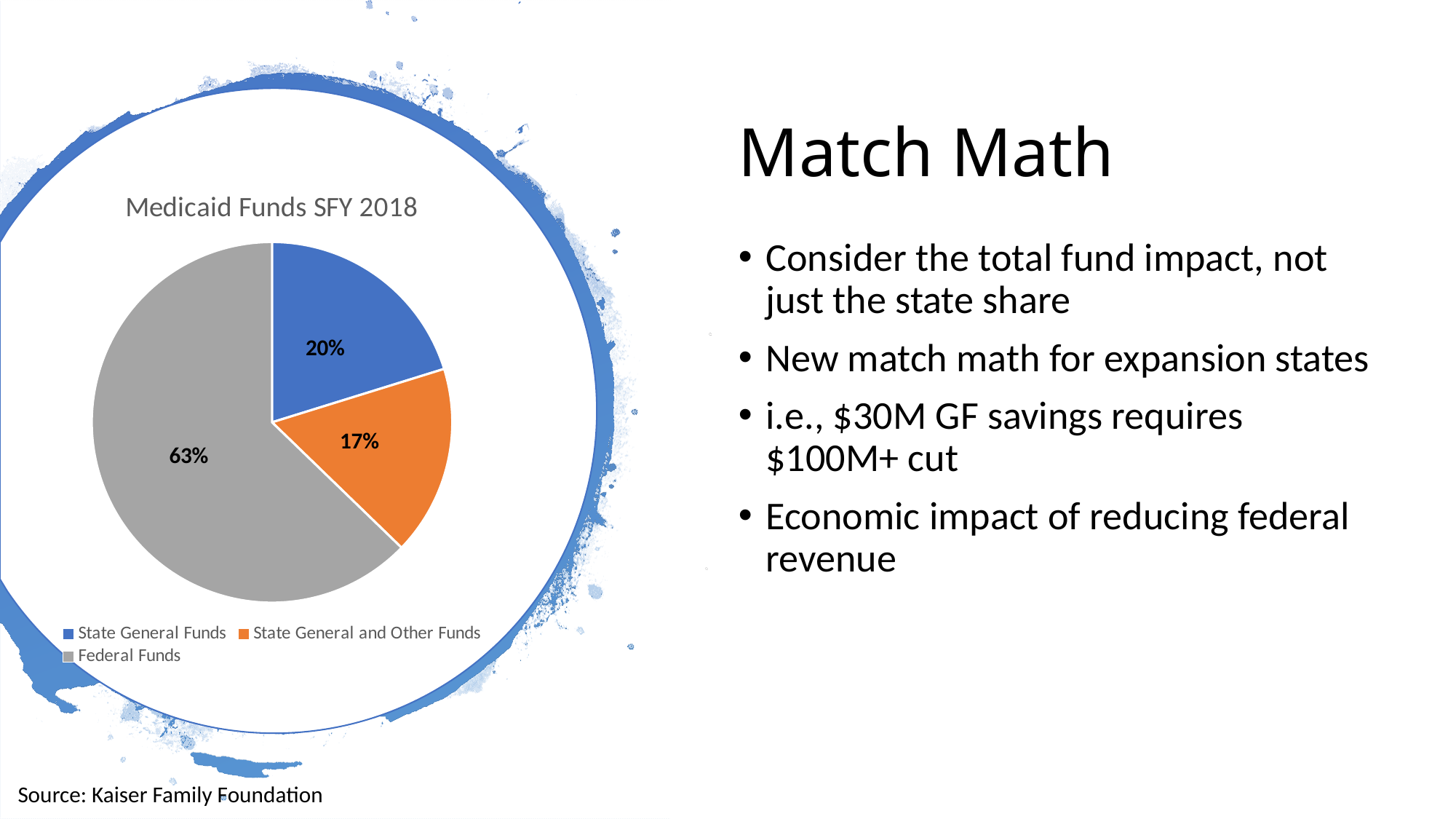
What is the difference in percentage points between Federal Funds and State General Funds? 43 Which category has the largest slice of the pie? Federal Funds Which category has the smallest slice of the pie? State General and Other Funds How many entries does the legend list? 3 What is the title of the chart? Medicaid Funds SFY 2018 How many slices does the pie chart have? 3 What type of chart is shown on the slide? pie chart What share of Medicaid Funds SFY 2018 comes from State General and Other Funds? 17% What share of Medicaid Funds SFY 2018 comes from Federal Funds? 63% What colour represents Federal Funds in the pie chart? gray Which is larger, the State General Funds slice or the State General and Other Funds slice? State General Funds What share of Medicaid Funds SFY 2018 comes from State General Funds? 20%